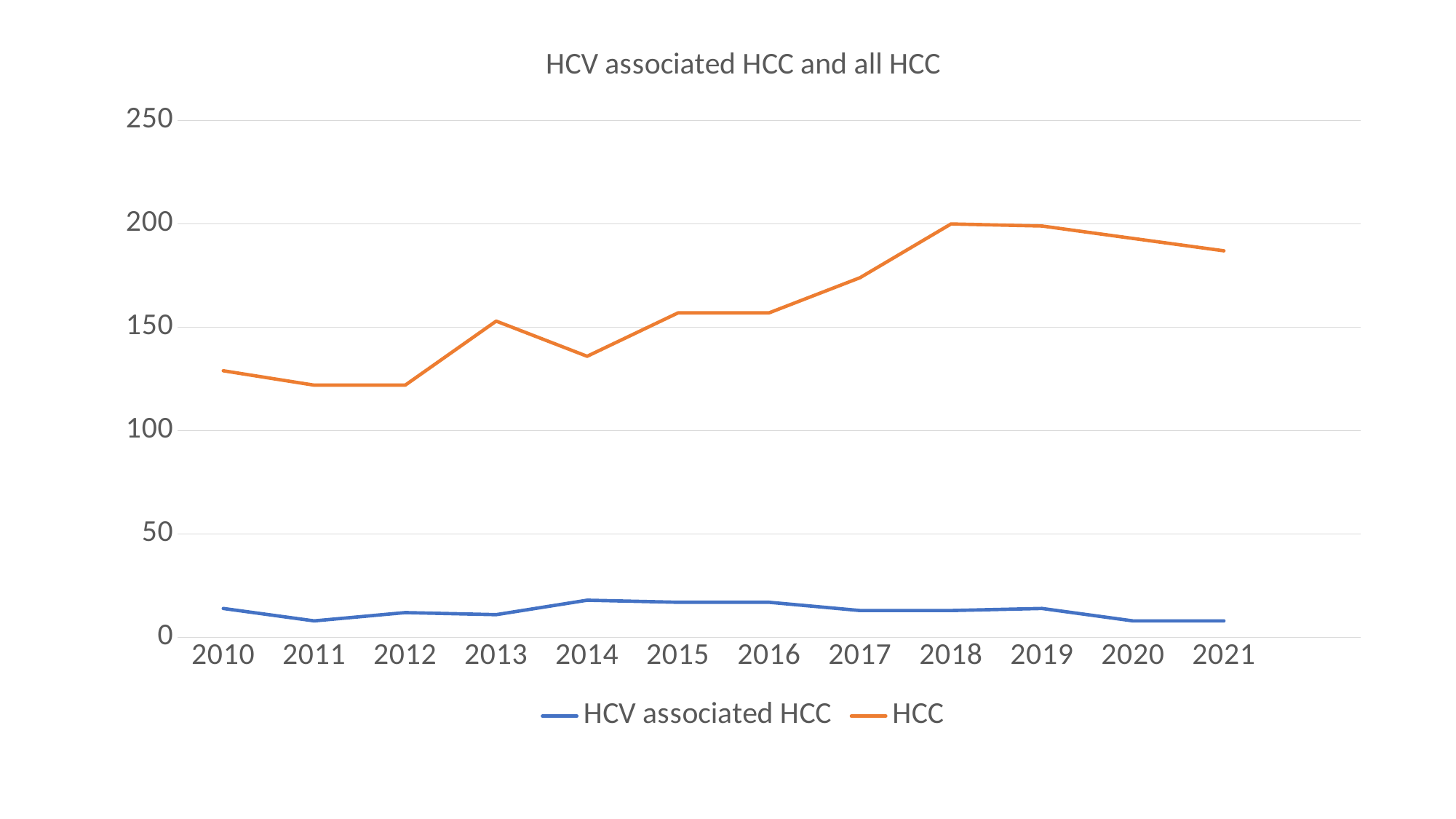
What kind of chart is shown on the slide? line chart Is the value for HCC in 2010 greater or less than 150? less Which is larger, the HCC value in 2013 or the HCC value in 2014? 2013 Is the value for HCC in 2018 greater or less than 150? greater In 2015, which series has the larger value, HCV associated HCC or HCC? HCC Is the value for HCV associated HCC in 2014 greater or less than 50? less What is the title of the chart? HCV associated HCC and all HCC Does the HCC line rise or fall from 2018 to 2021? fall How many series does the legend list? 2 Which colour is the HCC line? orange How many years are plotted along the x axis? 12